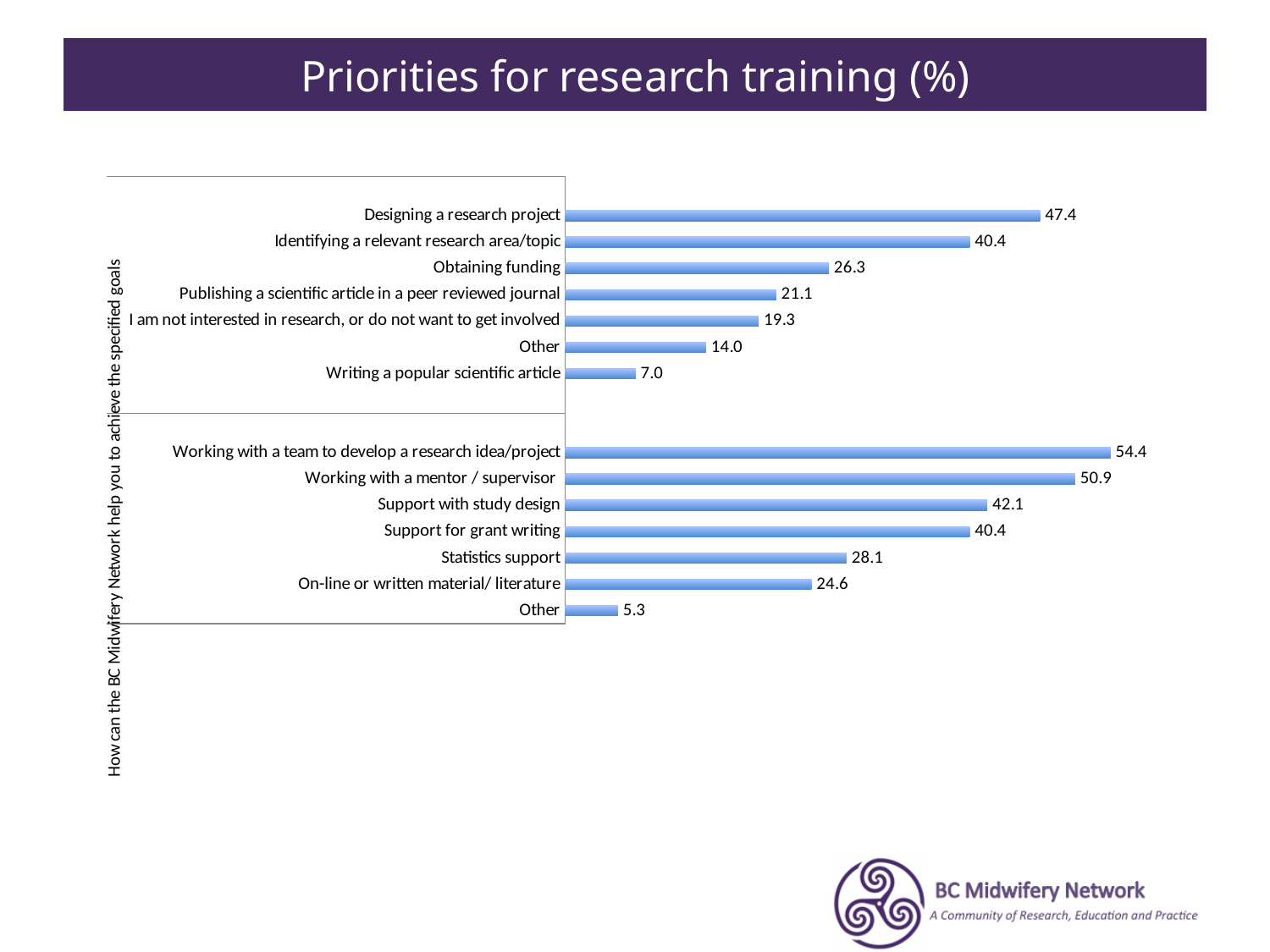
What is the value for "Working with a mentor / supervisor"? 50.9 What is the difference between "Designing a research project" and "Obtaining funding"? 21.1 What is the value for "Statistics support"? 28.1 What is the value for "Writing a popular scientific article"? 7.0 Which is larger: "Support with study design" or "Support for grant writing"? Support with study design What kind of chart is shown on the slide? Bar chart What is the value for "Designing a research project"? 47.4 What is the difference between "Working with a team to develop a research idea/project" and "Working with a mentor / supervisor"? 3.5 What is the title of the slide containing the chart? Priorities for research training (%) Which category has the lowest value on the chart? Other (in the lower group, 5.3) Which category has the highest value on the chart? Working with a team to develop a research idea/project How many bars are plotted on the chart in total? 14